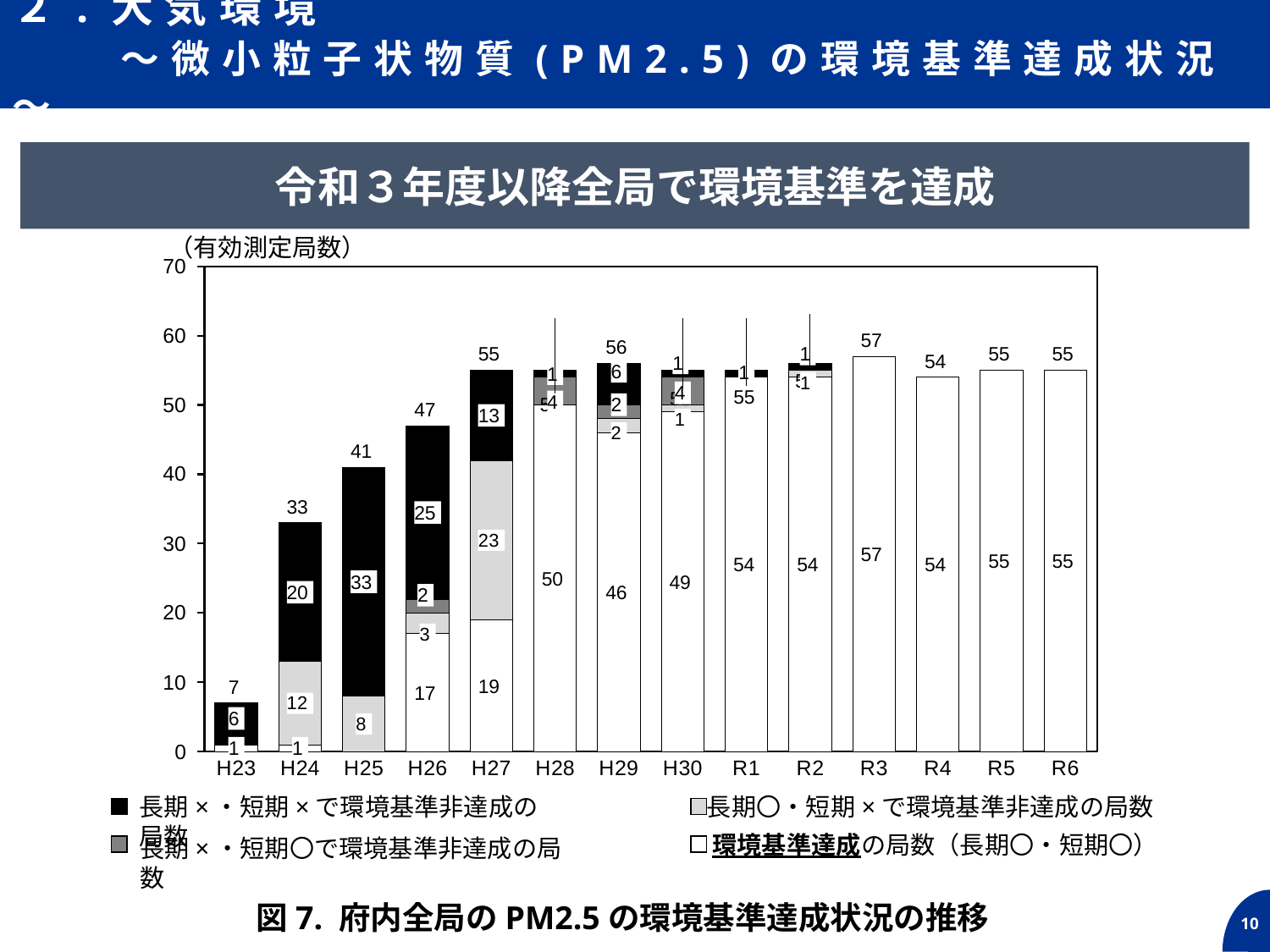
How many stations achieved the environmental standard (white segment) in H28? 50 Which has a larger total number of stations, H24 or H26? H26 Which fiscal year has the lowest total number of stations? H23 How many stations failed both the long-term and short-term standards (black segment) in H25? 33 How many stations achieved the environmental standard (white segment) in H27? 19 What kind of chart is shown on the slide? bar chart Which fiscal year has the highest total number of stations? R3 What is the difference between the total number of stations in R3 and R4? 3 How many series does the legend list? 4 What is the total number of valid measuring stations for H25? 41 How many fiscal years (categories) are shown on the x axis? 14 Do the total numbers of stations rise or fall from H23 to H27? rise